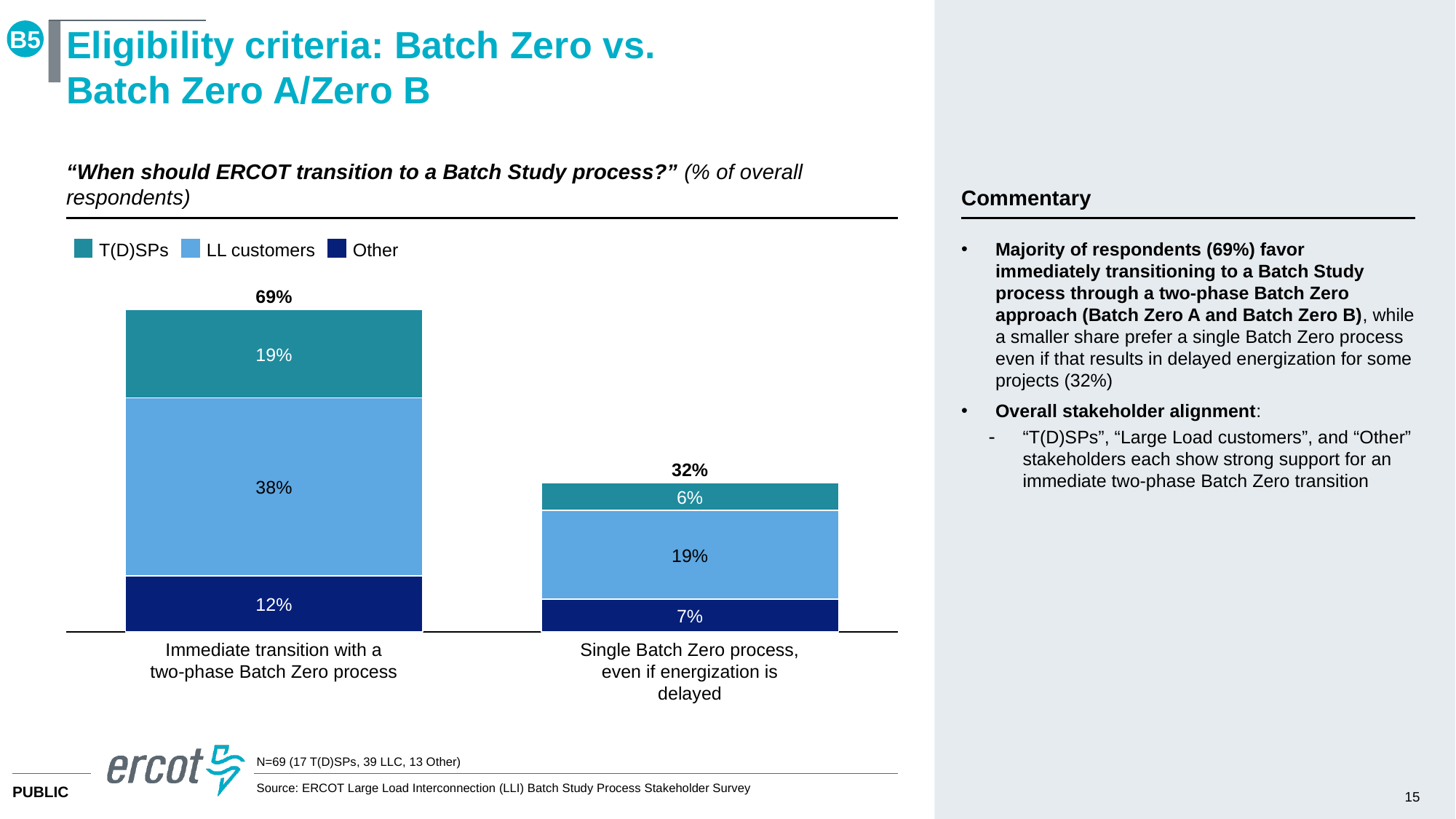
Which option has the higher total share of respondents? Immediate transition with a two-phase Batch Zero process What share of respondents chose 'Immediate transition with a two-phase Batch Zero process' in total? 69% How many series does the legend list? 3 Which series is shown in the darkest blue colour in the legend? Other What is the difference between the T(D)SPs values for the two options? 13% How many categories are shown on the x axis? 2 What is the LL customers value for 'Immediate transition with a two-phase Batch Zero process'? 38% Which is larger: the LL customers value for the immediate two-phase transition or the LL customers value for the single Batch Zero process? Immediate transition with a two-phase Batch Zero process What is the T(D)SPs value for 'Single Batch Zero process, even if energization is delayed'? 6% What is the difference between the total for 'Immediate transition with a two-phase Batch Zero process' and the total for 'Single Batch Zero process, even if energization is delayed'? 37% What is the Other value for 'Single Batch Zero process, even if energization is delayed'? 7% What kind of chart is shown on the slide? Stacked bar chart